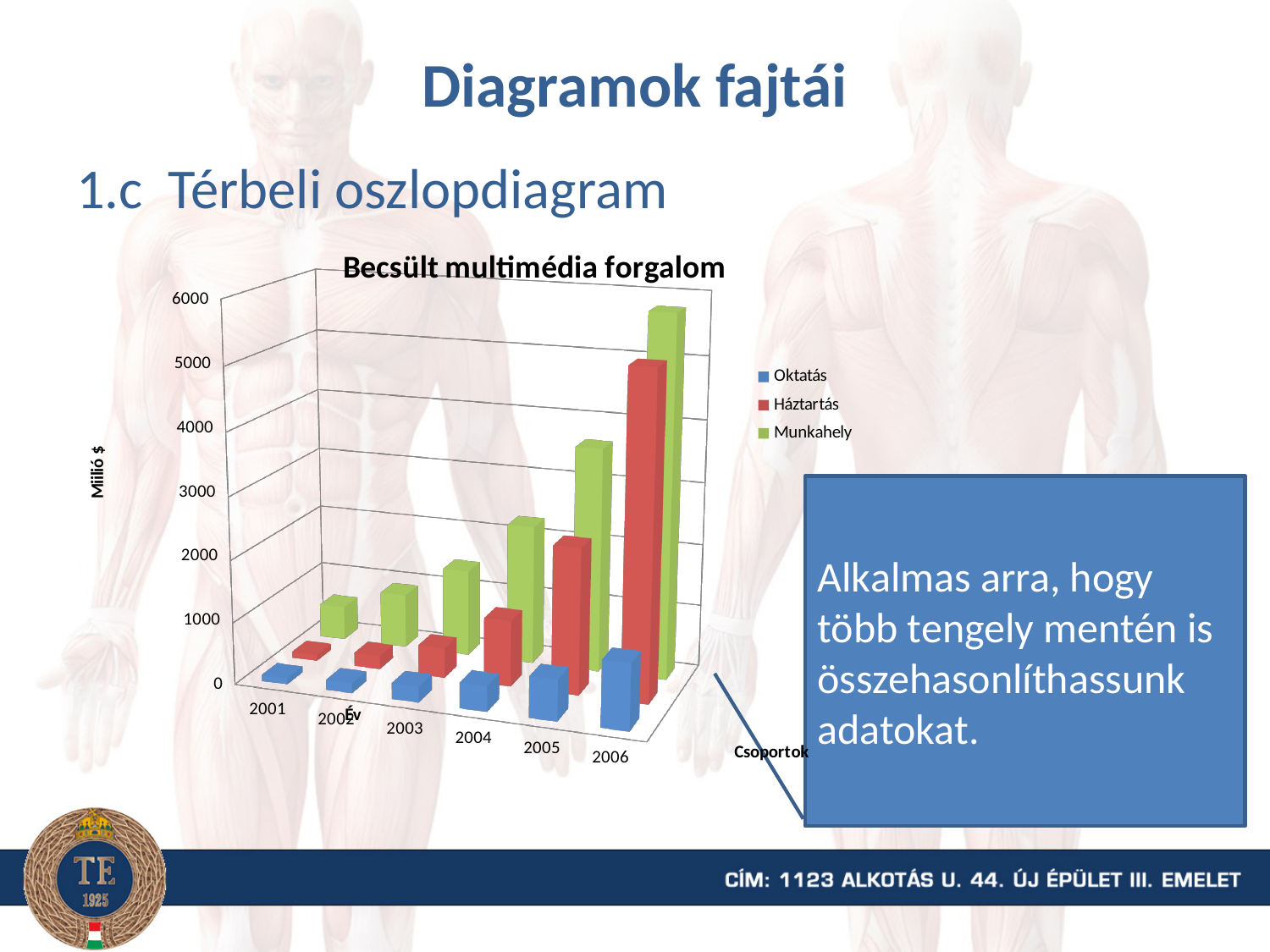
How many years are shown on the x axis of the chart? 6 What kind of chart is shown on the slide? bar chart What is the label of the vertical axis? Millió $ Do the values for Munkahely rise or fall from 2001 to 2006? rise Is the value for Munkahely in 2006 greater or less than 4000? greater How many series does the legend list? 3 Which is larger in 2006, Munkahely or Háztartás? Munkahely Is the value for Háztartás in 2006 greater or less than 3000? greater Is the value for Oktatás in 2001 greater or less than 1000? less Which series has the highest value in 2006? Munkahely What is the title of the chart? Becsült multimédia forgalom